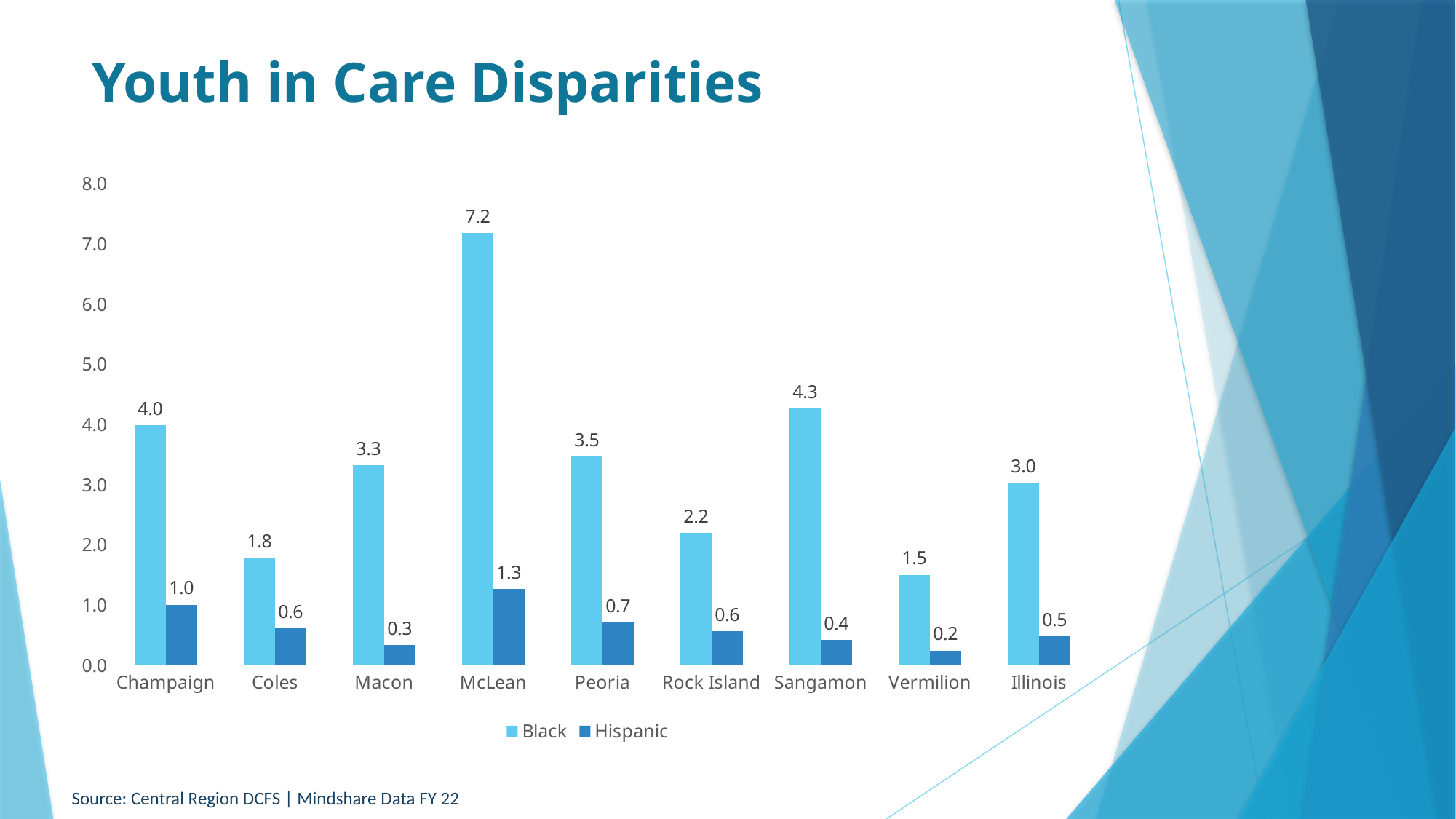
Which is larger, the Black value for Peoria or the Black value for Macon? Peoria What is the difference between the Black and Hispanic values for Sangamon? 3.9 What is the Hispanic value for Champaign? 1.0 What kind of chart is shown on the slide? Bar chart Which category has the lowest Hispanic value? Vermilion What is the Black value for McLean? 7.2 Which category has the highest Black value? McLean How many series does the legend list? 2 What is the title of the slide? Youth in Care Disparities What is the Hispanic value for Rock Island? 0.6 How many categories are shown on the x axis? 9 What is the Black value for Illinois? 3.0